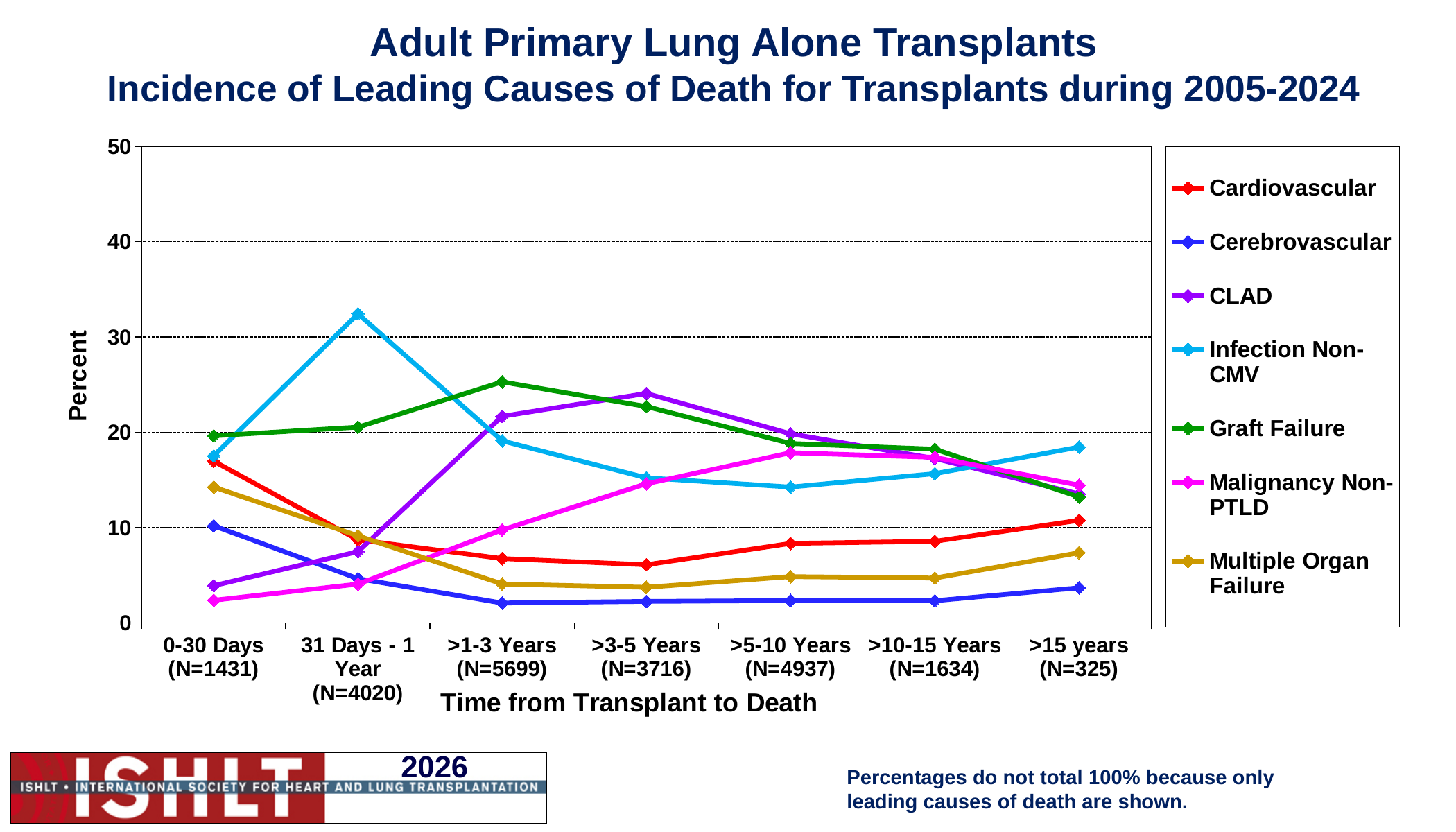
What type of chart is shown on the slide? line chart What is the title of the x axis? Time from Transplant to Death Does the Cerebrovascular line rise or fall from 0-30 Days to >1-3 Years? fall How many causes of death does the legend list? 7 How many time periods are shown on the x axis? 7 Which cause of death has the highest percentage in the 31 Days - 1 Year period? Infection Non-CMV Which cause of death has the lowest percentage in the >1-3 Years period? Cerebrovascular Is the value for Infection Non-CMV in the 31 Days - 1 Year period greater or less than 30? greater Is the value for Cardiovascular in the 0-30 Days period greater or less than 20? less Is the value for Graft Failure in the >1-3 Years period greater or less than 20? greater In the >3-5 Years period, which is larger: CLAD or Infection Non-CMV? CLAD Does the Malignancy Non-PTLD line rise or fall from 0-30 Days to >5-10 Years? rise